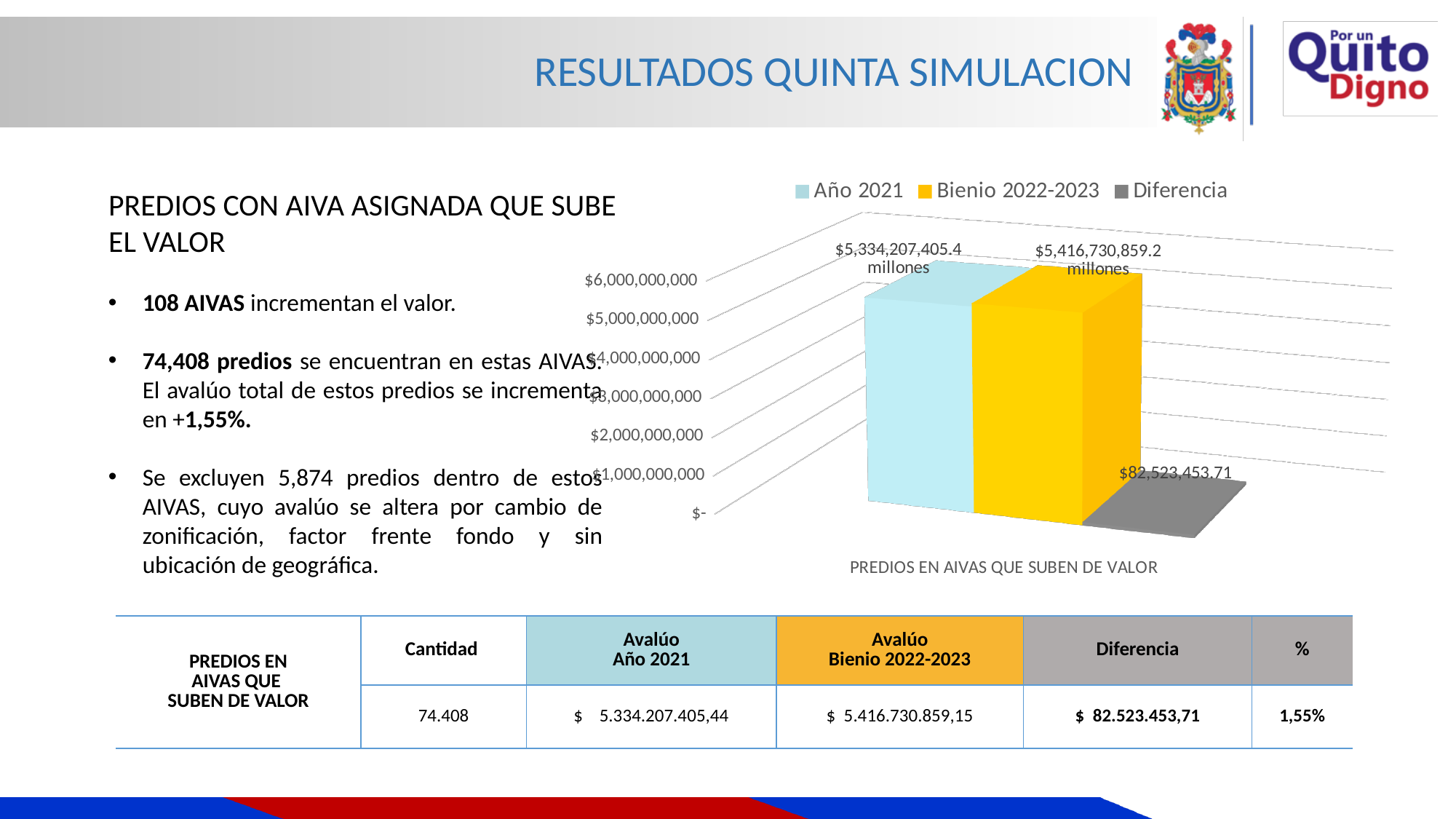
Which series has the shortest bar in the chart? Diferencia What is the data label shown on the Diferencia bar? $82,523,453.71 What is the data label shown on the Bienio 2022-2023 bar? $5,416,730,859.2 millones Is the value for Diferencia greater or less than $1,000,000,000? less Which series has the tallest bar in the chart? Bienio 2022-2023 What kind of chart is shown on the slide? bar chart What is the data label shown on the Año 2021 bar? $5,334,207,405.4 millones What are the three series listed in the chart legend? Año 2021, Bienio 2022-2023, Diferencia What is the category label shown below the chart's x axis? PREDIOS EN AIVAS QUE SUBEN DE VALOR Which bar is taller, Año 2021 or Bienio 2022-2023? Bienio 2022-2023 How many series does the chart legend list? 3 Is the value for Año 2021 greater or less than $5,000,000,000? greater